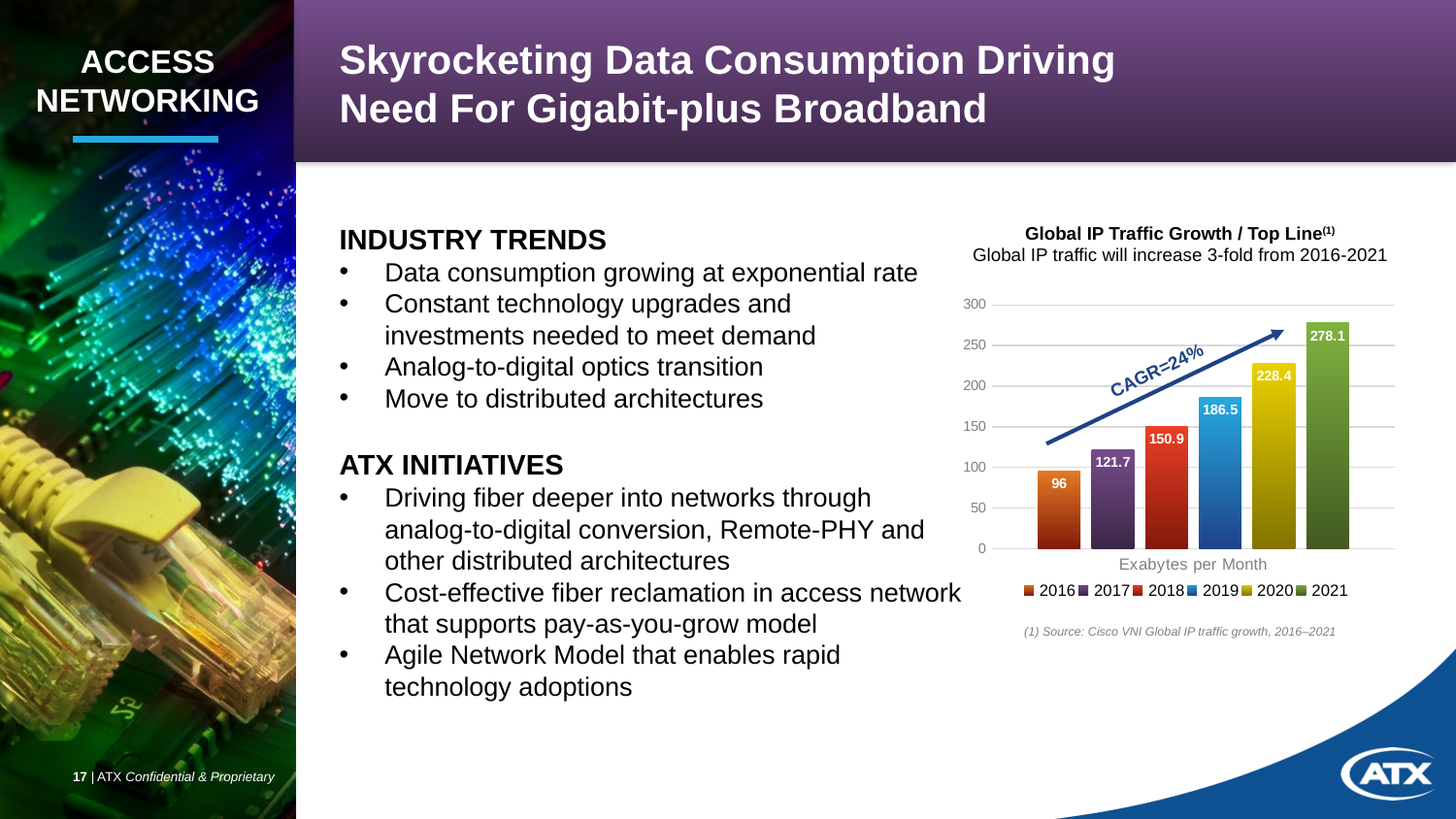
Which year has the highest value in the Global IP Traffic Growth chart? 2021 What is the difference between the 2021 and 2016 values in the Global IP Traffic Growth chart? 182.1 How many entries does the legend of the Global IP Traffic Growth chart list? 6 Which year has the lowest value in the Global IP Traffic Growth chart? 2016 Which is larger in the Global IP Traffic Growth chart, the value for 2020 or the value for 2019? 2020 Do the values in the Global IP Traffic Growth chart rise or fall from 2016 to 2021? Rise What is the value for 2019 in the Global IP Traffic Growth chart? 186.5 What is the difference between the 2018 and 2017 values in the Global IP Traffic Growth chart? 29.2 What kind of chart is the Global IP Traffic Growth chart? Bar chart How many years are shown in the Global IP Traffic Growth chart? 6 What is the value for 2021 in the Global IP Traffic Growth chart? 278.1 What is the value for 2016 in the Global IP Traffic Growth chart? 96